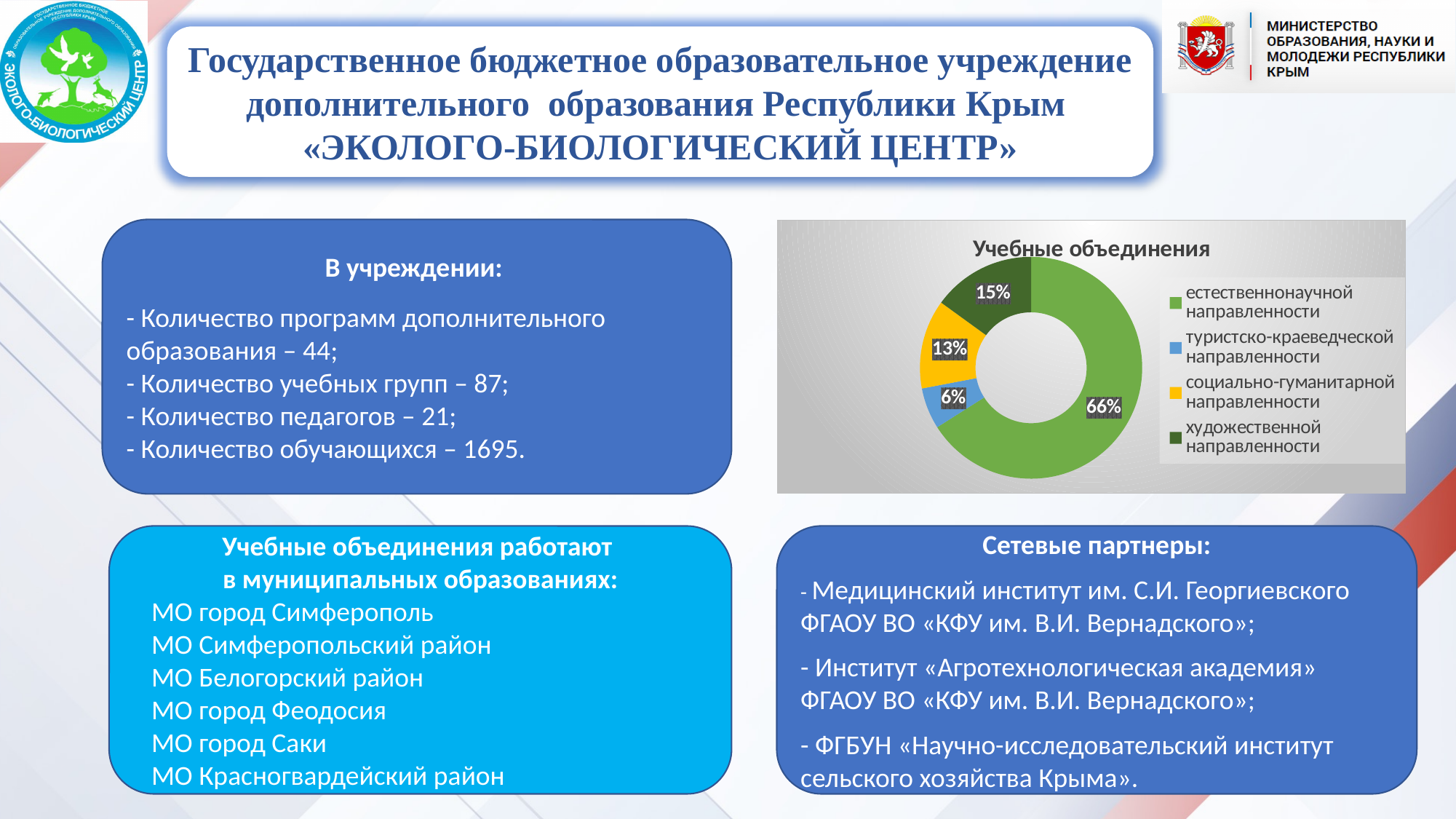
What is the title of the chart on the slide? Учебные объединения What type of chart is shown on the slide? doughnut chart Which category has the smallest share in the chart? туристско-краеведческой направленности What share of the chart is taken by художественной направленности? 15% How many categories does the chart show? 4 What share of the chart is taken by естественнонаучной направленности? 66% Which is larger: the share of художественной направленности or социально-гуманитарной направленности? художественной направленности Which category has the largest share in the chart? естественнонаучной направленности What is the difference in percentage points between художественной направленности and социально-гуманитарной направленности? 2 What share of the chart is taken by социально-гуманитарной направленности? 13% What colour represents социально-гуманитарной направленности in the chart? yellow